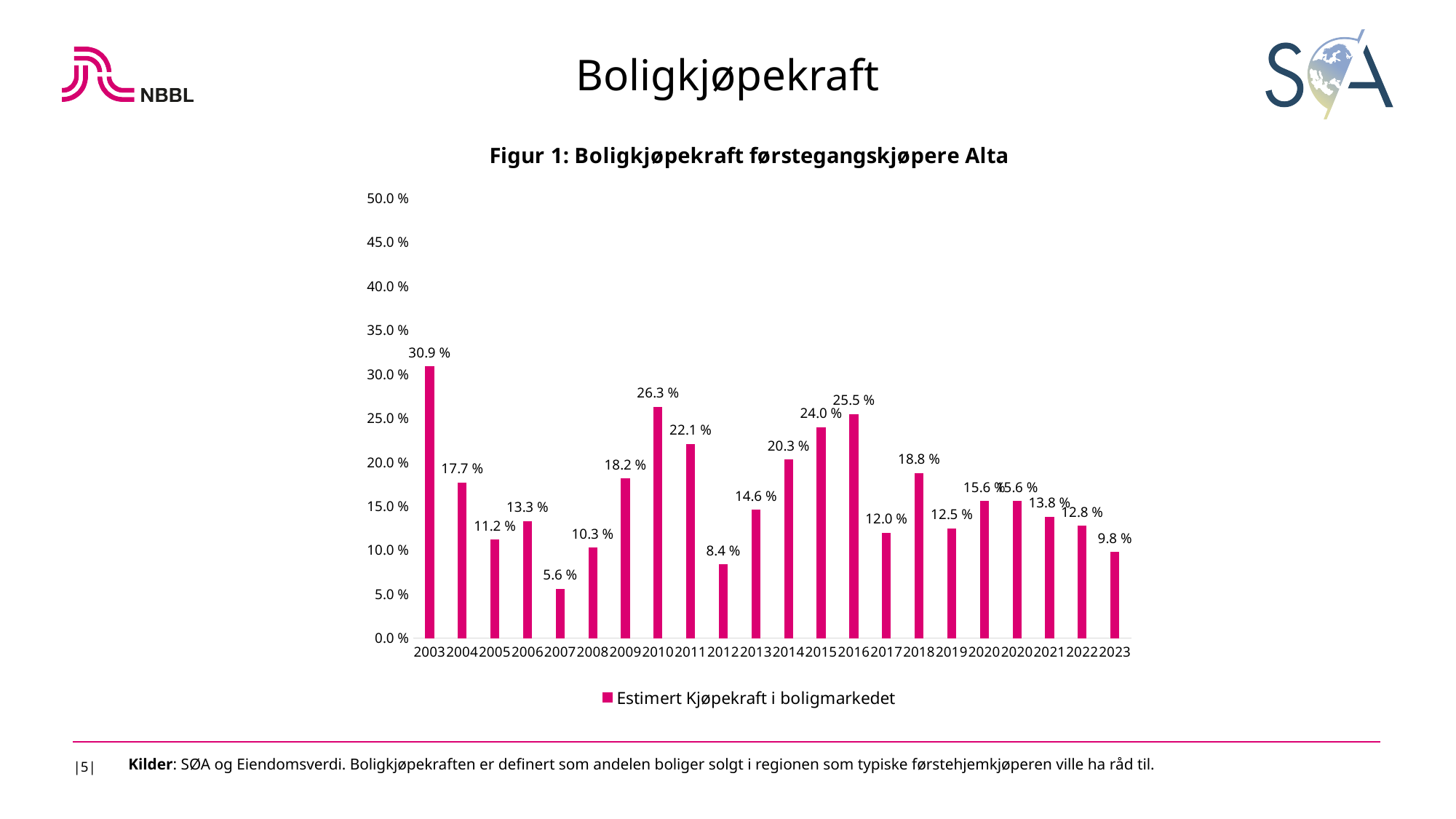
What is the value for 2023? 9.8 % Which is larger, the value for 2015 or the value for 2016? 2016 Is the value for 2011 greater or less than 20.0 %? greater Which year has the lowest value? 2007 How many bars are plotted in the chart? 22 Which year has the highest value? 2003 What is the legend entry for the series? Estimert Kjøpekraft i boligmarkedet What is the value for 2003? 30.9 % What kind of chart is shown? bar chart What is the value for 2010? 26.3 % What is the difference between the values for 2016 and 2017? 13.5 % How many series does the legend list? 1